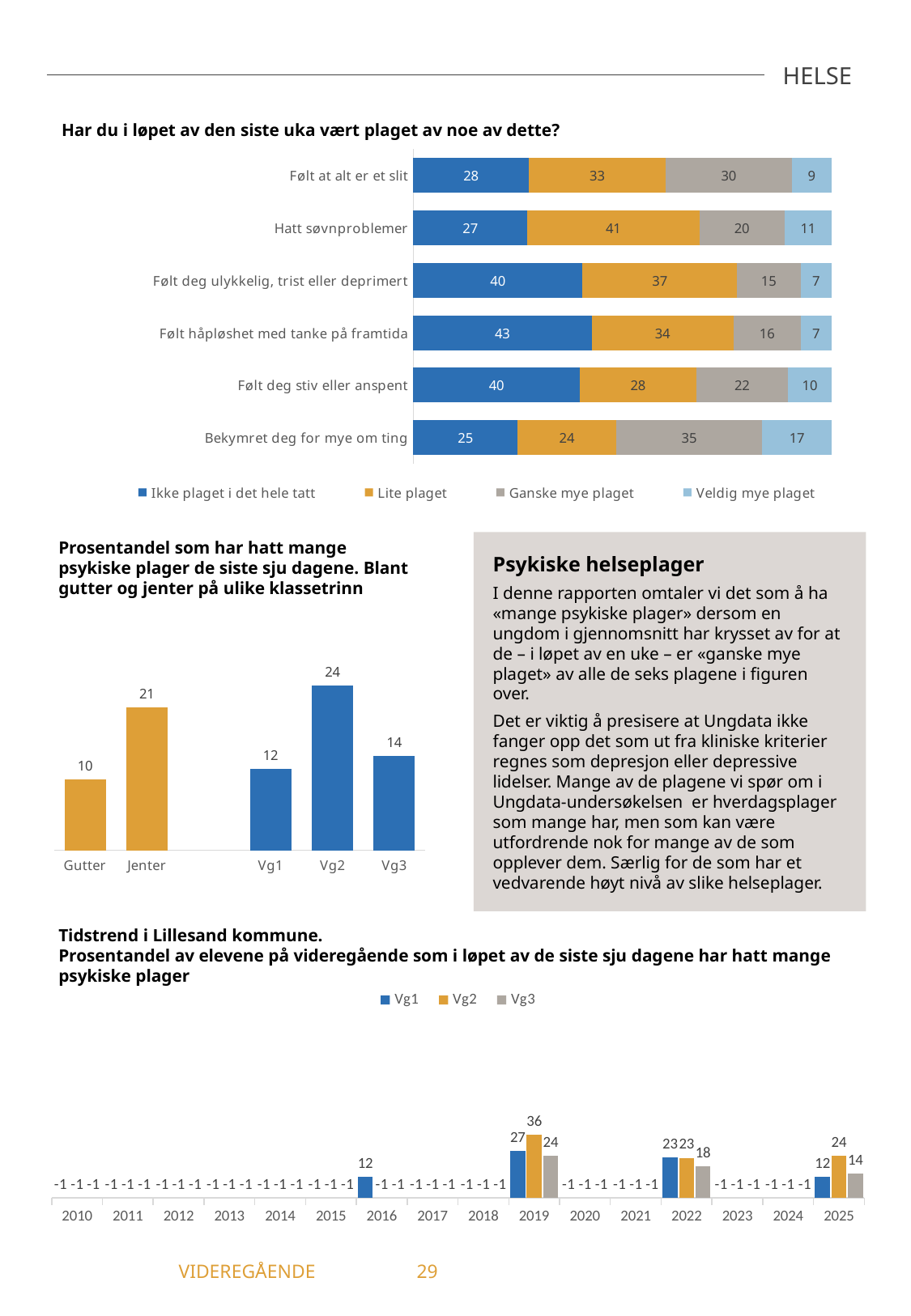
In the chart 'Har du i løpet av den siste uka vært plaget av noe av dette?', how many categories are shown? 6 In the chart 'Har du i løpet av den siste uka vært plaget av noe av dette?', which category has the highest value for 'Veldig mye plaget'? Bekymret deg for mye om ting In the chart 'Prosentandel som har hatt mange psykiske plager de siste sju dagene', which class level has the highest value? Vg2 In the chart 'Har du i løpet av den siste uka vært plaget av noe av dette?', what is the difference between 'Ganske mye plaget' for 'Bekymret deg for mye om ting' and for 'Følt deg ulykkelig, trist eller deprimert'? 20 In the chart 'Tidstrend i Lillesand kommune', what is the value for Vg2 in 2019? 36 In the chart 'Har du i løpet av den siste uka vært plaget av noe av dette?', what is the value for 'Lite plaget' in the 'Hatt søvnproblemer' bar? 41 In the chart 'Tidstrend i Lillesand kommune', which is larger in 2025: Vg1 or Vg3? Vg3 What kind of chart is 'Tidstrend i Lillesand kommune'? Bar chart In the chart 'Har du i løpet av den siste uka vært plaget av noe av dette?', how many series does the legend list? 4 In the chart 'Prosentandel som har hatt mange psykiske plager de siste sju dagene', what is the difference between Jenter and Gutter? 11 In the chart 'Prosentandel som har hatt mange psykiske plager de siste sju dagene', what is the value for Jenter? 21 In the chart 'Har du i løpet av den siste uka vært plaget av noe av dette?', which category has the highest value for 'Ikke plaget i det hele tatt'? Følt håpløshet med tanke på framtida